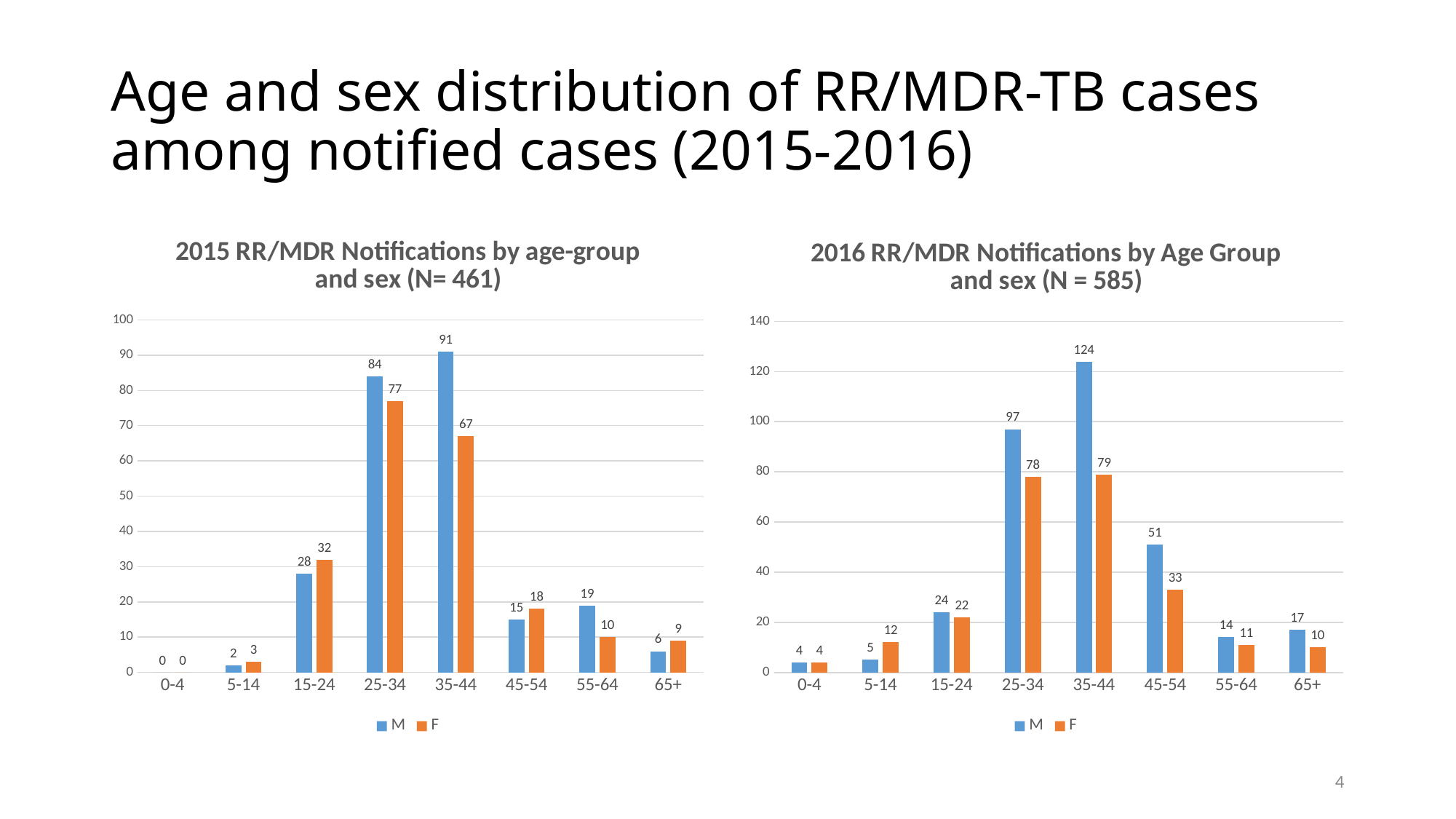
How many age groups are shown on the x axis of the 2015 RR/MDR Notifications chart? 8 In the 2016 RR/MDR Notifications chart, what is the value for F in the 45-54 age group? 33 What colour represents the F series in the 2015 RR/MDR Notifications chart? Orange In the 2016 RR/MDR Notifications chart, which is larger for the 15-24 age group, M or F? M What kind of chart is the 2015 RR/MDR Notifications chart? Bar chart In the 2015 RR/MDR Notifications chart, which age group has the lowest F value? 0-4 In the 2015 RR/MDR Notifications chart, what is the difference between the M and F values for the 25-34 age group? 7 How many series does the legend of the 2016 RR/MDR Notifications chart list? 2 In the 2016 RR/MDR Notifications chart, what is the difference between the M values for 35-44 and 45-54? 73 In the 2015 RR/MDR Notifications chart, what is the value for M in the 35-44 age group? 91 In the 2016 RR/MDR Notifications chart, is the M value for 25-34 greater or less than 80? greater In the 2016 RR/MDR Notifications chart, which age group has the highest M value? 35-44